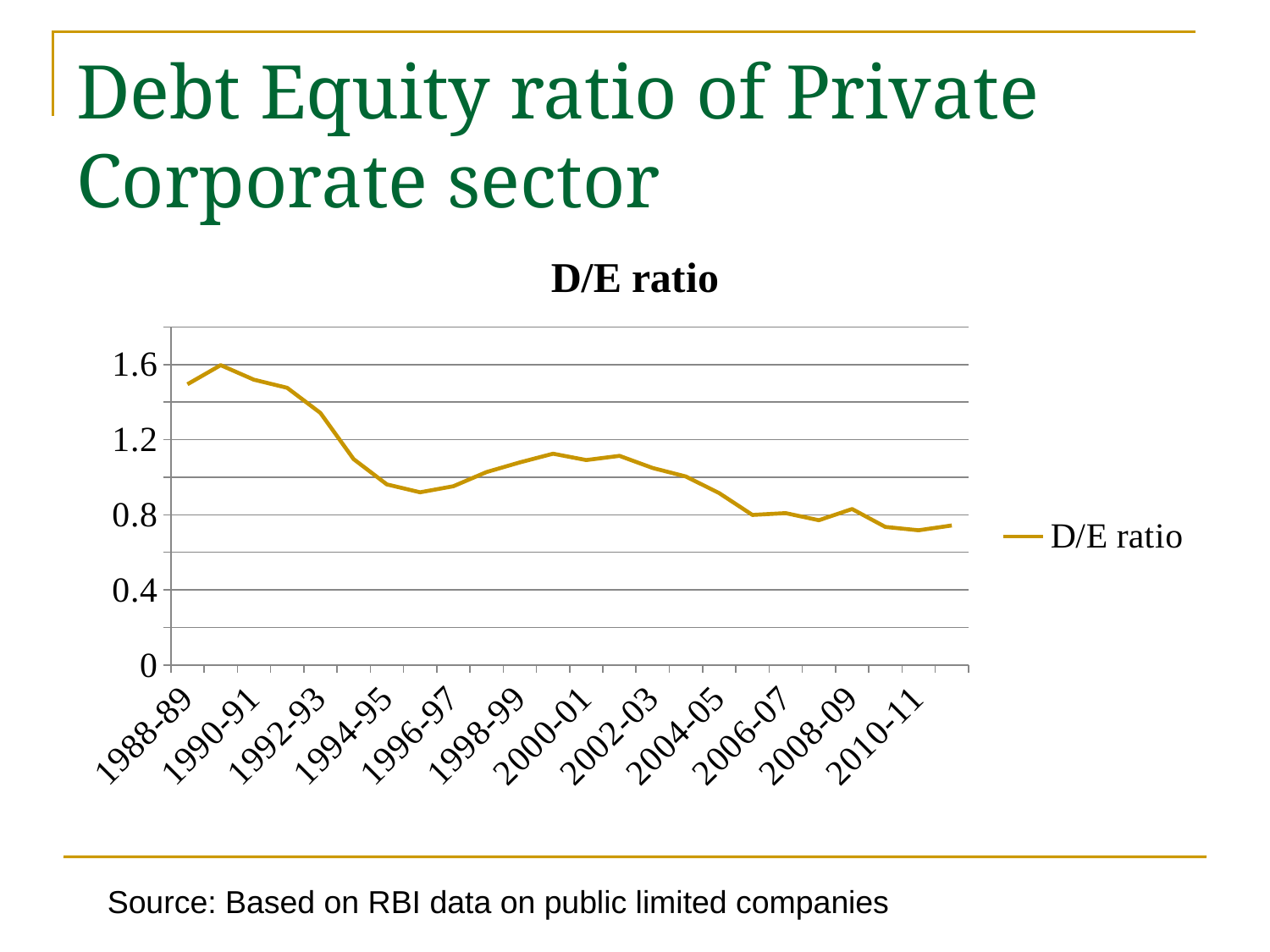
Is the D/E ratio for 2004-05 greater or less than 1.2? less What kind of chart is shown on the slide? line chart Is the D/E ratio for 1988-89 greater or less than 1.2? greater Which has the larger D/E ratio, 1992-93 or 2000-01? 1992-93 Is the D/E ratio for 1992-93 greater or less than 1.2? greater How many series does the legend list? 1 What is the title of the chart? D/E ratio Which has the larger D/E ratio, 1988-89 or 2010-11? 1988-89 Overall, does the D/E ratio rise or fall from 1988-89 to 2010-11? fall